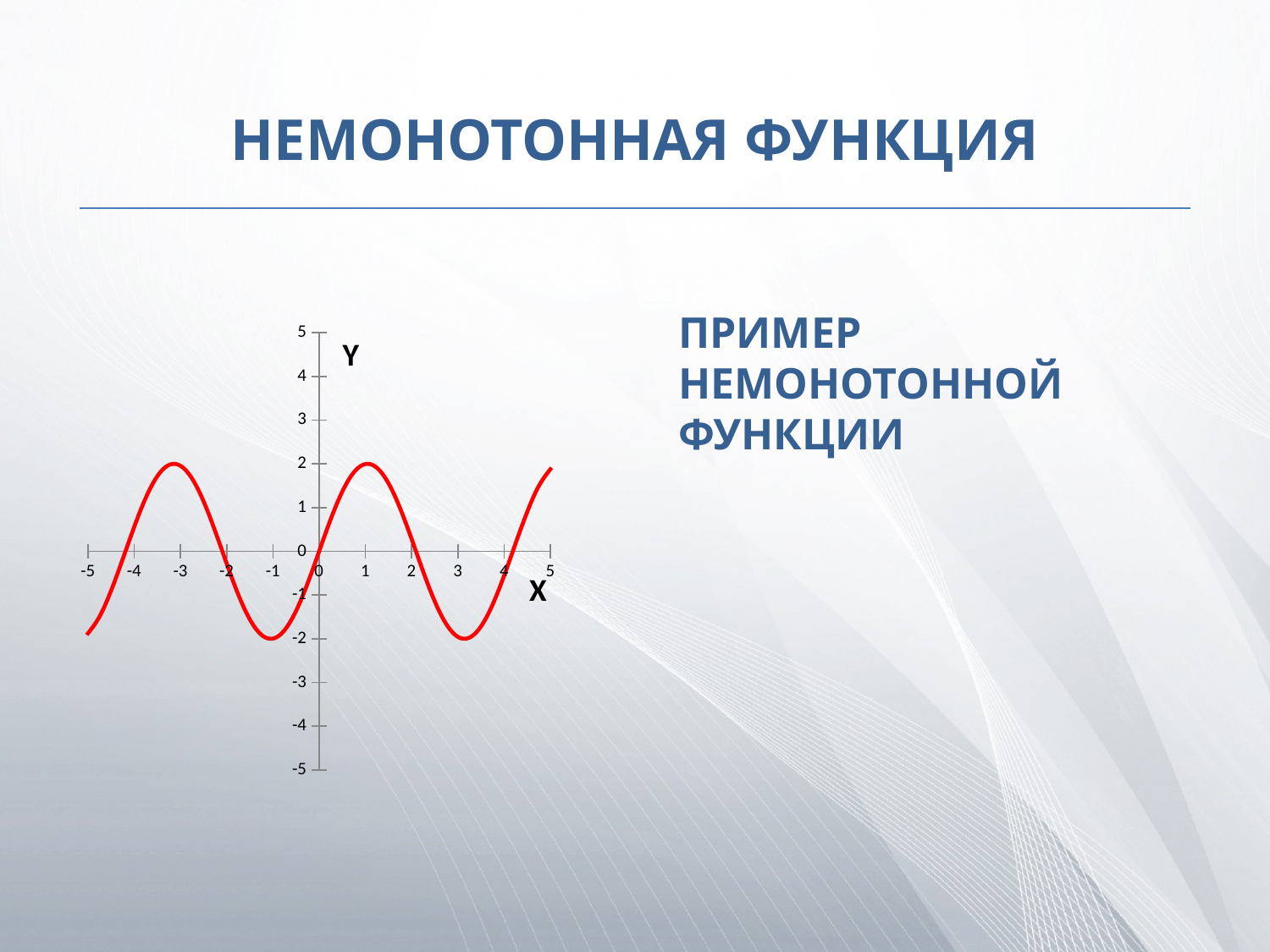
Is the value of the curve at x = -1 greater or less than -1? less What is the label of the horizontal axis? X What is the highest value the red curve reaches on the Y axis? 2 Is the value of the curve at x = -3 greater or less than 1? greater Does the curve rise or fall as x goes from 1 to 3? fall What is the lowest value the red curve reaches on the Y axis? -2 Is the value of the curve at x = 1 greater or less than 1? greater What colour is the plotted curve? red What kind of chart is shown on the slide? line chart Which is larger, the value of the curve at x = 1 or at x = 3? x = 1 Does the curve rise or fall as x goes from -1 to 1? rise